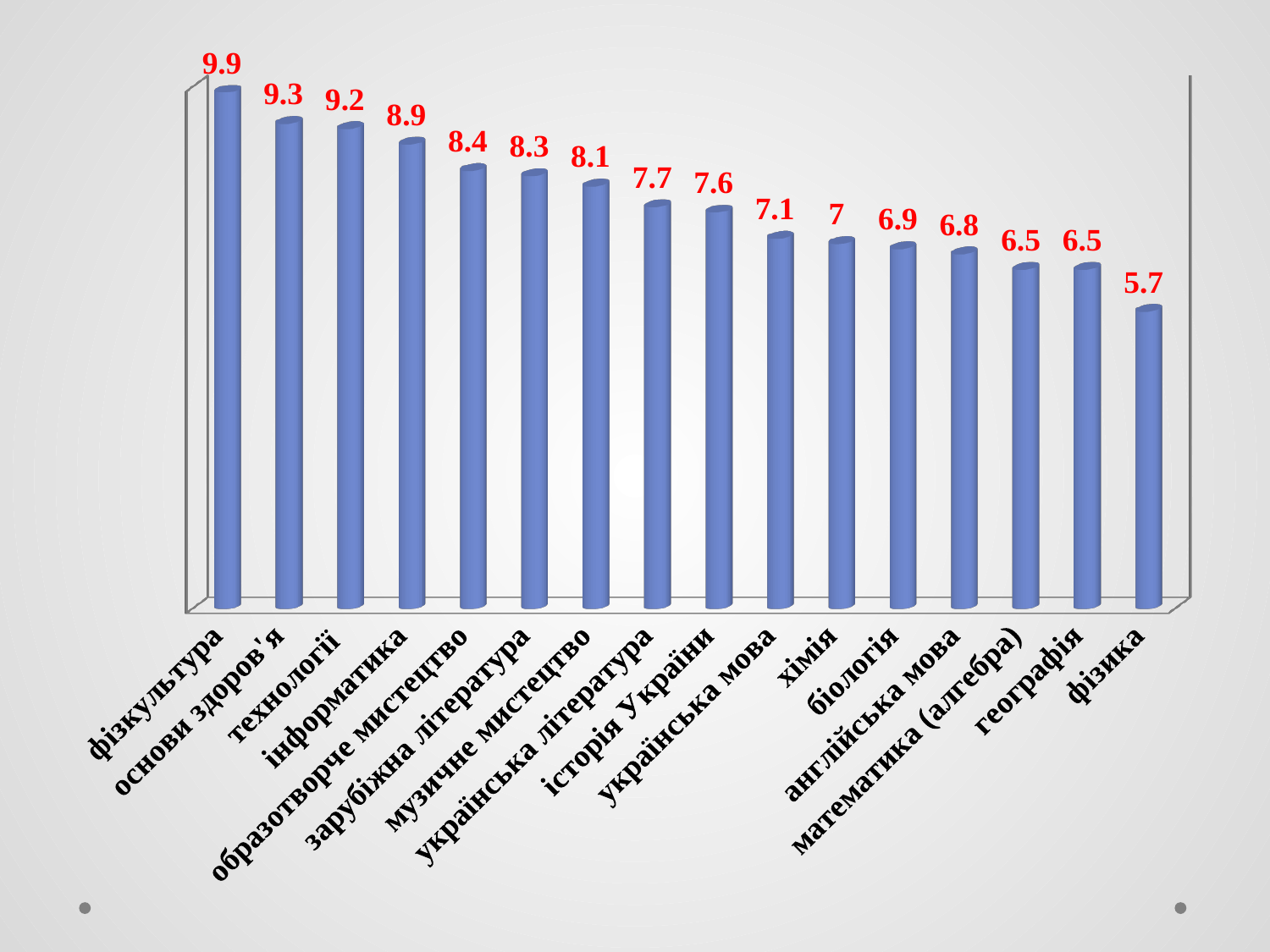
What is the difference between the values for фізкультура and фізика? 4.2 What is the value for історія України? 7.6 Which category has the highest value? фізкультура Do the values rise or fall from left to right along the x axis? fall What is the value for англійська мова? 6.8 What is the value for фізкультура? 9.9 Which category has the lowest value? фізика Which is larger, the value for зарубіжна література or the value for українська література? зарубіжна література What is the value for інформатика? 8.9 How many categories are shown in the chart? 16 What is the difference between the values for технології and хімія? 2.2 What kind of chart is this? bar chart